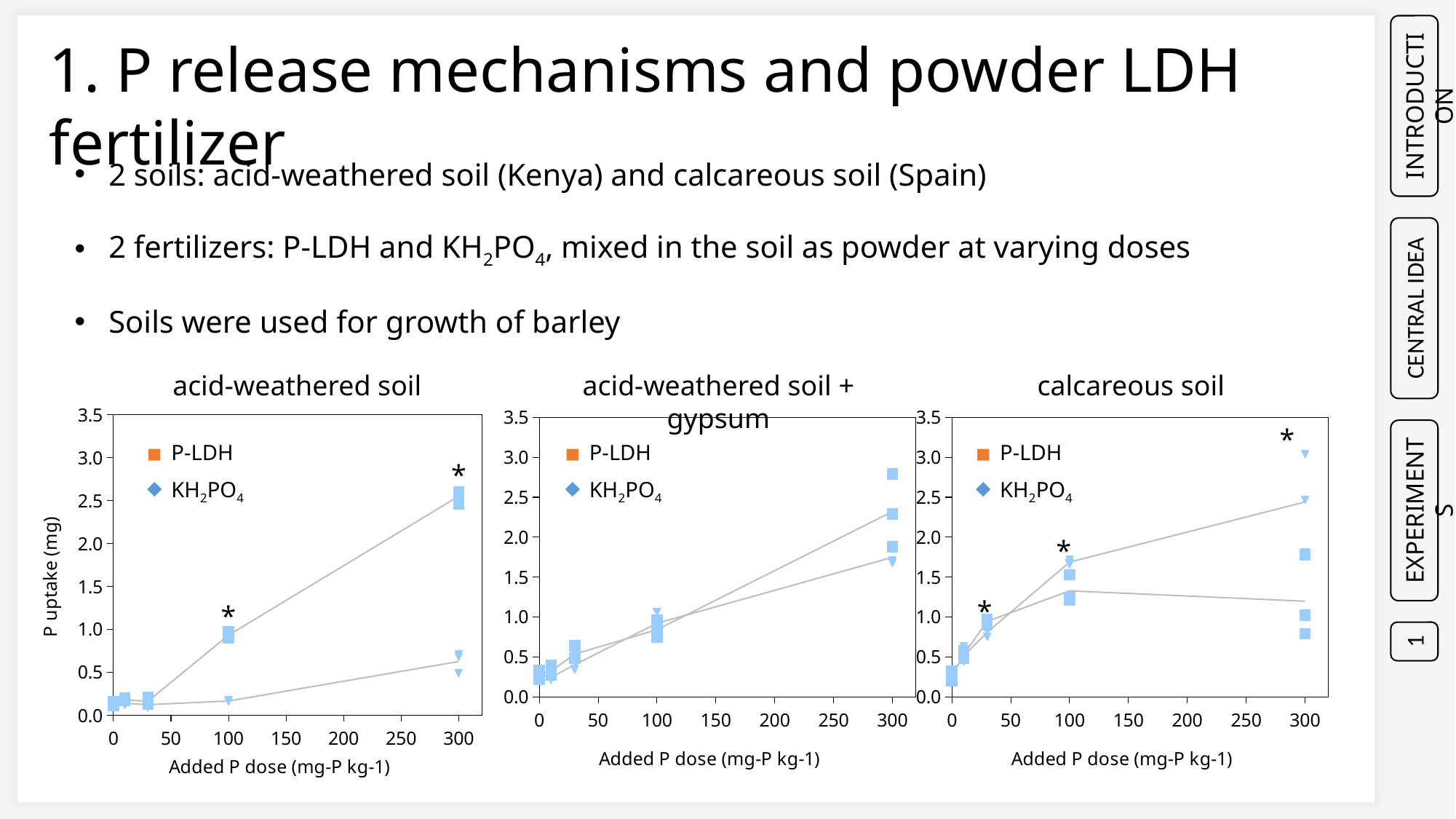
In the 'acid-weathered soil' chart, which series has the higher P uptake at an added P dose of 300, P-LDH or KH2PO4? P-LDH In the 'acid-weathered soil' chart, is the P uptake for P-LDH at an added P dose of 300 greater or less than 2.0? greater In the 'acid-weathered soil' chart, does the P uptake for P-LDH rise or fall as the added P dose increases? rise What is the label of the y axis on the 'acid-weathered soil' chart? P uptake (mg) What is the label of the x axis on the 'calcareous soil' chart? Added P dose (mg-P kg-1) How many series does the legend of the 'calcareous soil' chart list? 2 What kind of chart is the 'acid-weathered soil' chart? scatter chart In the 'acid-weathered soil + gypsum' chart, which series has the higher P uptake at an added P dose of 300, P-LDH or KH2PO4? P-LDH In the 'acid-weathered soil' chart, is the P uptake for P-LDH at an added P dose of 100 greater or less than 0.5? greater In the 'calcareous soil' chart, which series has the higher P uptake at an added P dose of 300, P-LDH or KH2PO4? KH2PO4 In the 'acid-weathered soil' chart, is the P uptake for KH2PO4 at an added P dose of 300 greater or less than 1.0? less